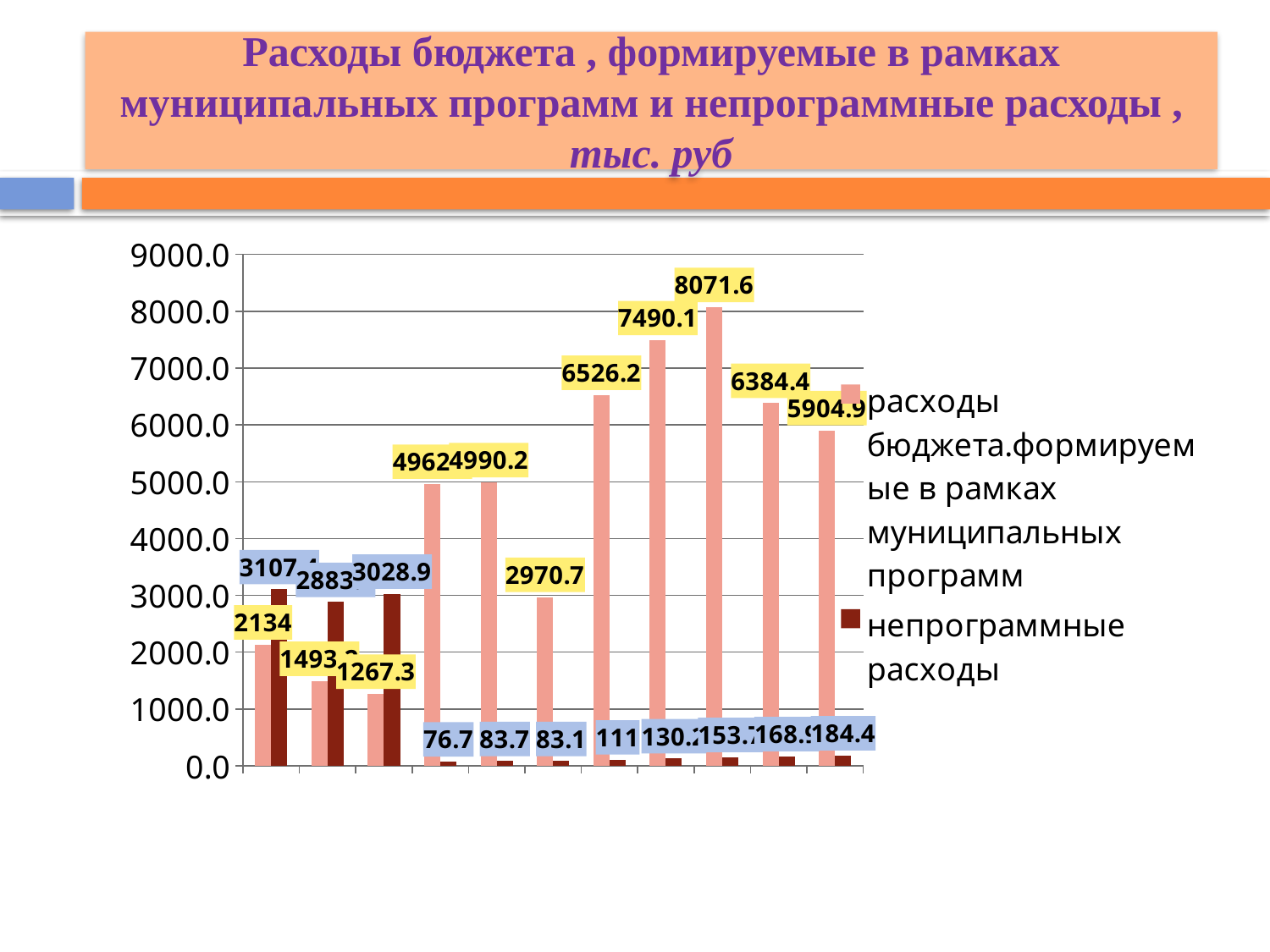
What is the value of the last (rightmost) bar of the series 'непрограммные расходы'? 184.4 What is the lowest value shown for the series 'непрограммные расходы'? 76.7 Is the value of the first (leftmost) bar of the series 'непрограммные расходы' greater or less than 3000? greater What is the value of the last (rightmost) bar of the series 'расходы бюджета, формируемые в рамках муниципальных программ'? 5904.9 What is the highest value shown for the series 'расходы бюджета, формируемые в рамках муниципальных программ'? 8071.6 Which is larger: the bar labelled 6384.4 or the bar labelled 5904.9? 6384.4 How many groups of bars are plotted along the x axis? 11 In what units are the values on the chart expressed, according to the slide title? тыс. руб What is the difference between the two highest values of the series 'расходы бюджета, формируемые в рамках муниципальных программ' (8071.6 and 7490.1)? 581.5 What is the lowest value shown for the series 'расходы бюджета, формируемые в рамках муниципальных программ'? 1267.3 How many series does the legend list? 2 What kind of chart is shown on the slide? bar chart